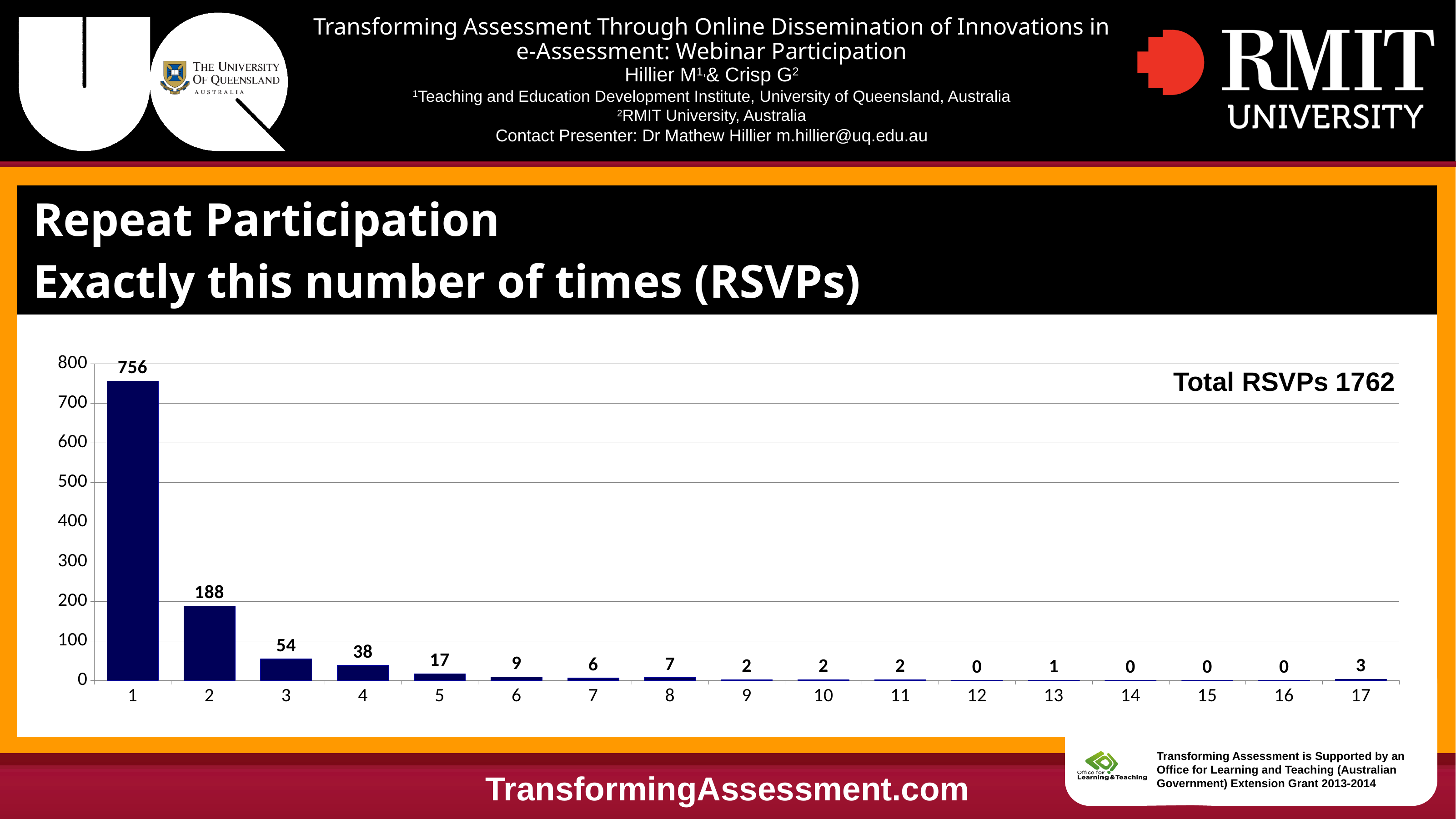
What kind of chart is shown on the slide? bar chart What is the difference between the values for categories 3 and 4? 16 What is the value for category 5? 17 What is the difference between the values for categories 1 and 2? 568 How many categories are shown on the x axis? 17 Which category has the highest value? 1 What is the value for category 2? 188 What total RSVPs figure is printed on the chart? Total RSVPs 1762 What is the value for category 17? 3 Which is larger, the value for category 7 or the value for category 8? 8 Is the value for category 2 greater or less than 100? greater What is the value for category 1? 756